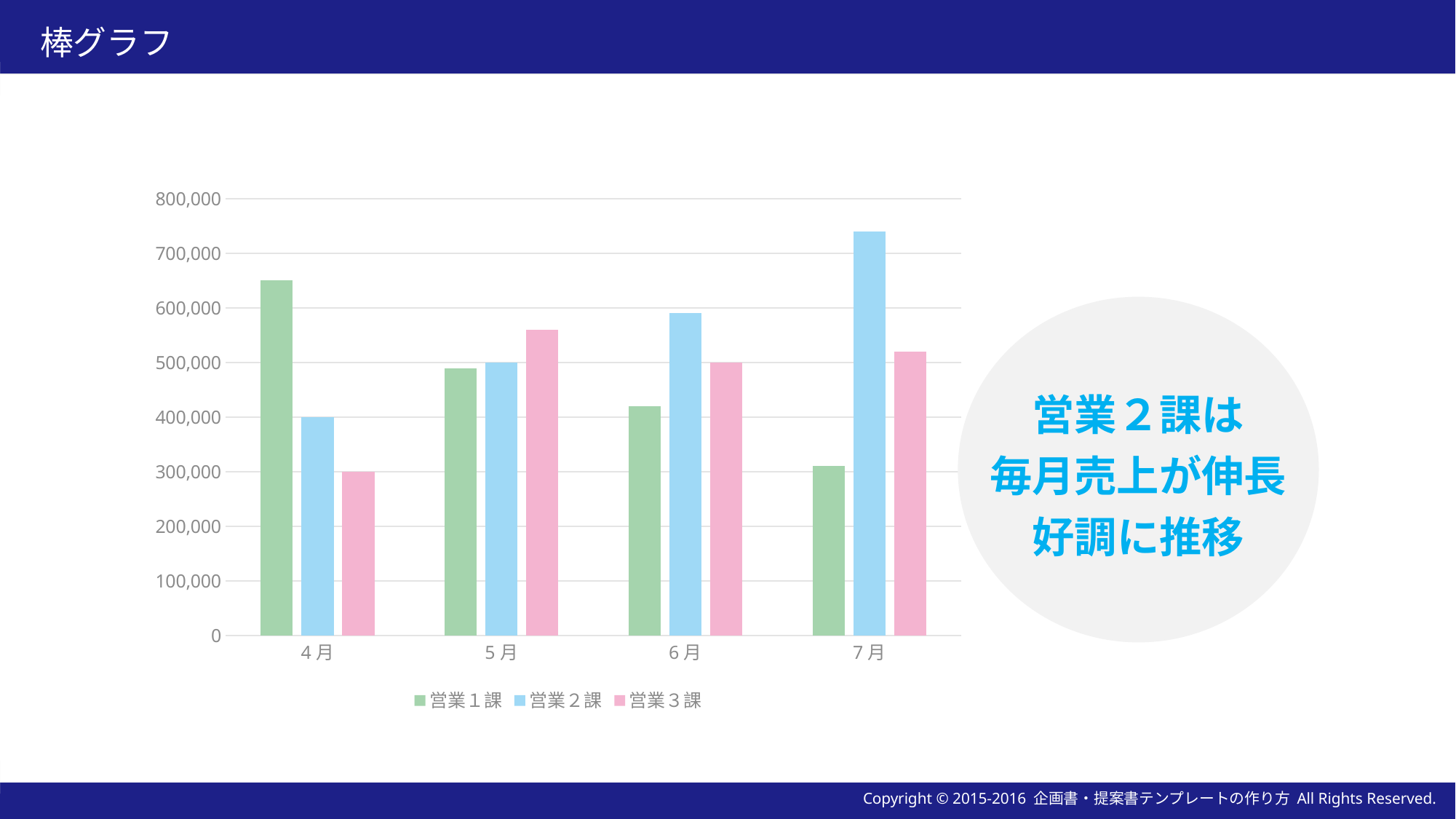
What is the value for 営業2課 in 4月? 400,000 Does the value for 営業2課 rise or fall from 4月 to 7月? rise What is the value for 営業2課 in 5月? 500,000 What is the value for 営業3課 in 4月? 300,000 How many months are shown on the x axis? 4 Which month has the highest value for 営業2課? 7月 What type of chart is shown on the slide? bar chart Is the value for 営業1課 in 7月 greater or less than 400,000? less Which month has the lowest value for 営業1課? 7月 How many series does the legend list? 3 Is the value for 営業2課 in 7月 greater or less than 700,000? greater What is the value for 営業3課 in 6月? 500,000